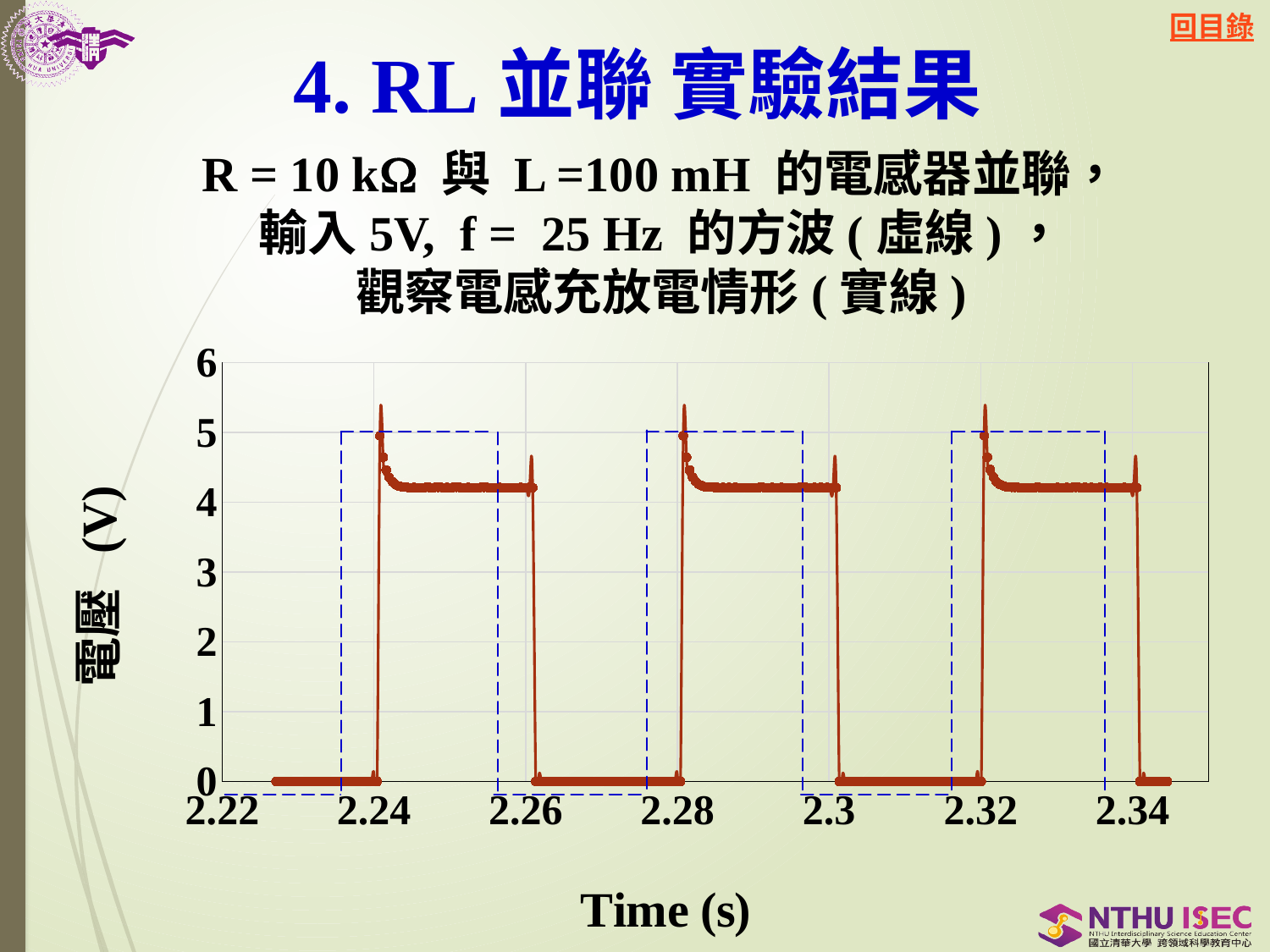
Which is higher during a pulse: the dashed square wave level or the steady plateau of the solid line? the dashed square wave level What is the highest value shown on the x axis of the chart? 2.34 How many high pulses of the dashed square wave are visible in the chart? 3 What is the highest value shown on the y axis of the chart? 6 What is the label of the y axis of the chart? 電壓 (V) Is the steady plateau of the solid line during each pulse greater or less than 4 V? greater What kind of chart is shown on the slide? line chart Is the peak spike of the solid line at the start of each pulse greater or less than 5 V? greater What is the lowest value shown on the x axis of the chart? 2.22 Is the steady plateau of the solid line during each pulse greater or less than 5 V? less What voltage level does the dashed square wave reach when it is high? 5 What is the label of the x axis of the chart? Time (s)